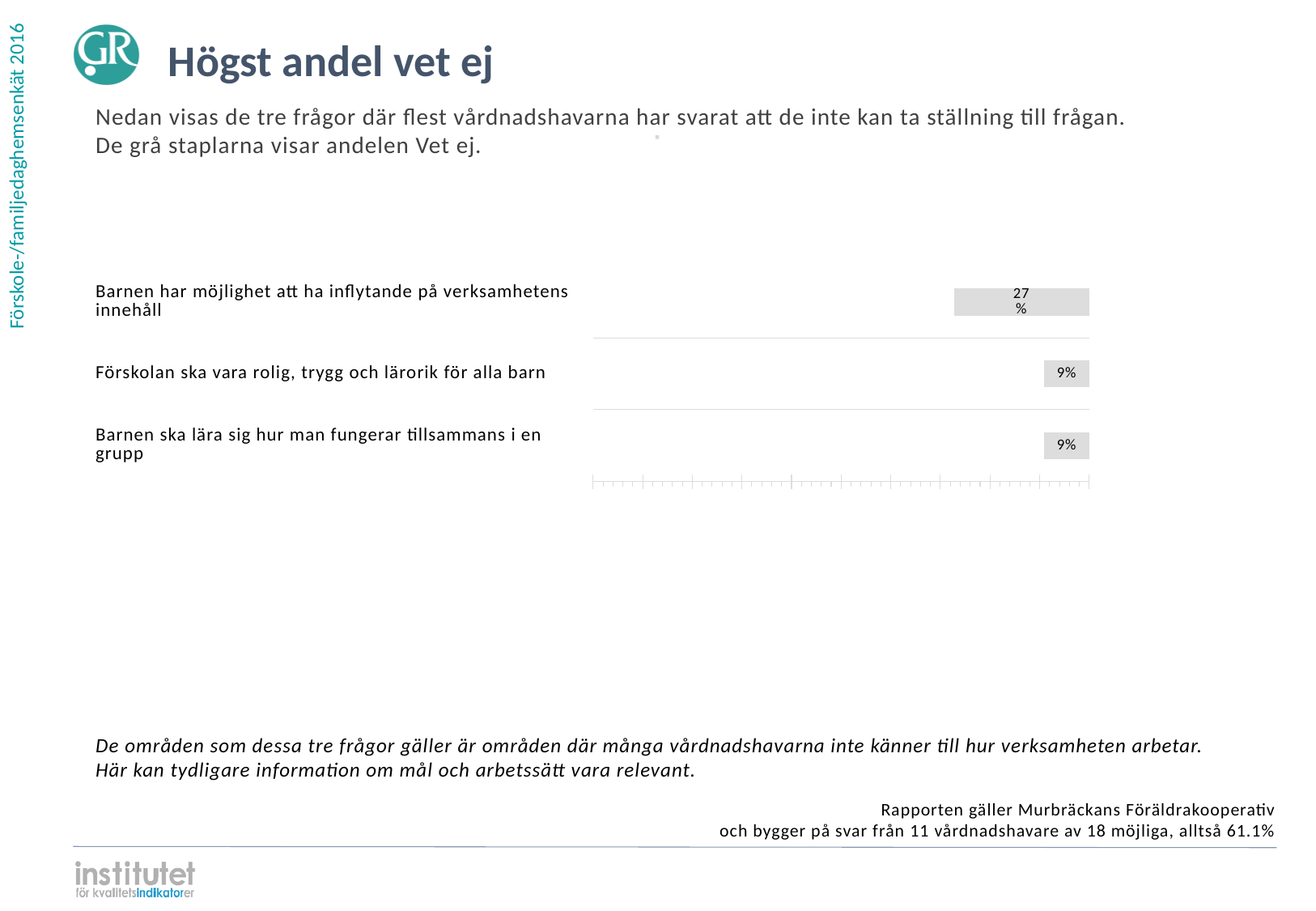
What colour are the bars in the chart? Grey How many of the three questions have a Vet ej share of 9%? 2 What kind of chart is shown on the slide? Bar chart What is the Vet ej share for "Barnen ska lära sig hur man fungerar tillsammans i en grupp"? 9% What is the title of the slide containing the chart? Högst andel vet ej Which question has the highest share of Vet ej answers? Barnen har möjlighet att ha inflytande på verksamhetens innehåll What is the Vet ej share for "Förskolan ska vara rolig, trygg och lärorik för alla barn"? 9% What is the Vet ej share for "Barnen har möjlighet att ha inflytande på verksamhetens innehåll"? 27% What is the difference between the Vet ej share for "Barnen har möjlighet att ha inflytande på verksamhetens innehåll" and for "Förskolan ska vara rolig, trygg och lärorik för alla barn"? 18 percentage points How many questions (categories) are shown in the chart? 3 Which is larger: the Vet ej share for "Barnen har möjlighet att ha inflytande på verksamhetens innehåll" or for "Barnen ska lära sig hur man fungerar tillsammans i en grupp"? Barnen har möjlighet att ha inflytande på verksamhetens innehåll